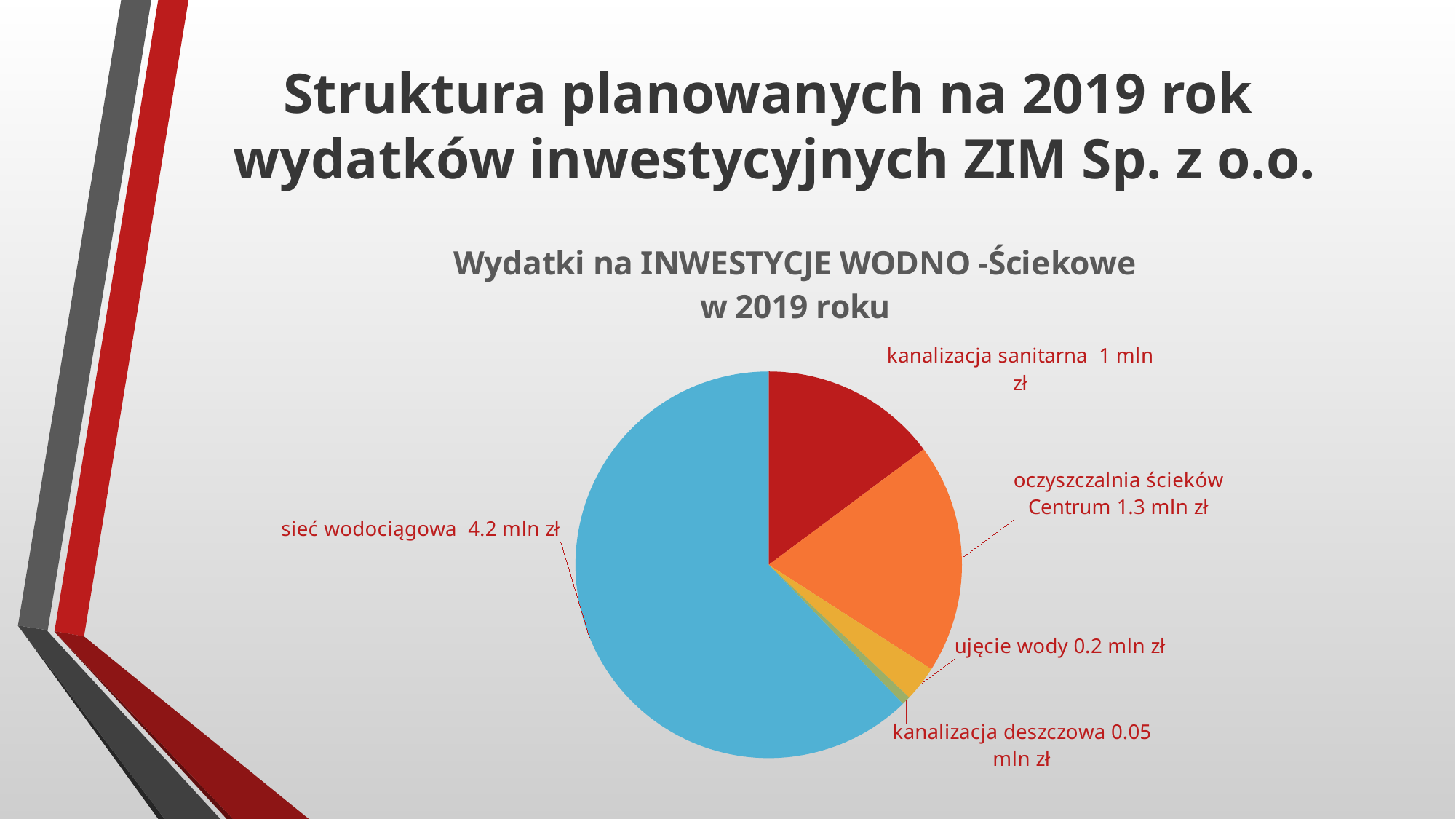
Which is larger, the value for oczyszczalnia ścieków Centrum or the value for kanalizacja sanitarna? oczyszczalnia ścieków Centrum What is the title of the chart? Wydatki na INWESTYCJE WODNO -Ściekowe w 2019 roku How many slices does the pie chart have? 5 What is the difference between the values for sieć wodociągowa and oczyszczalnia ścieków Centrum? 2.9 mln zł What is the value for kanalizacja sanitarna? 1 mln zł What is the value for kanalizacja deszczowa? 0.05 mln zł What is the value for oczyszczalnia ścieków Centrum? 1.3 mln zł What kind of chart is shown on the slide? pie chart Which category has the largest slice of the pie? sieć wodociągowa Which category has the smallest slice of the pie? kanalizacja deszczowa What is the value for sieć wodociągowa? 4.2 mln zł What is the value for ujęcie wody? 0.2 mln zł